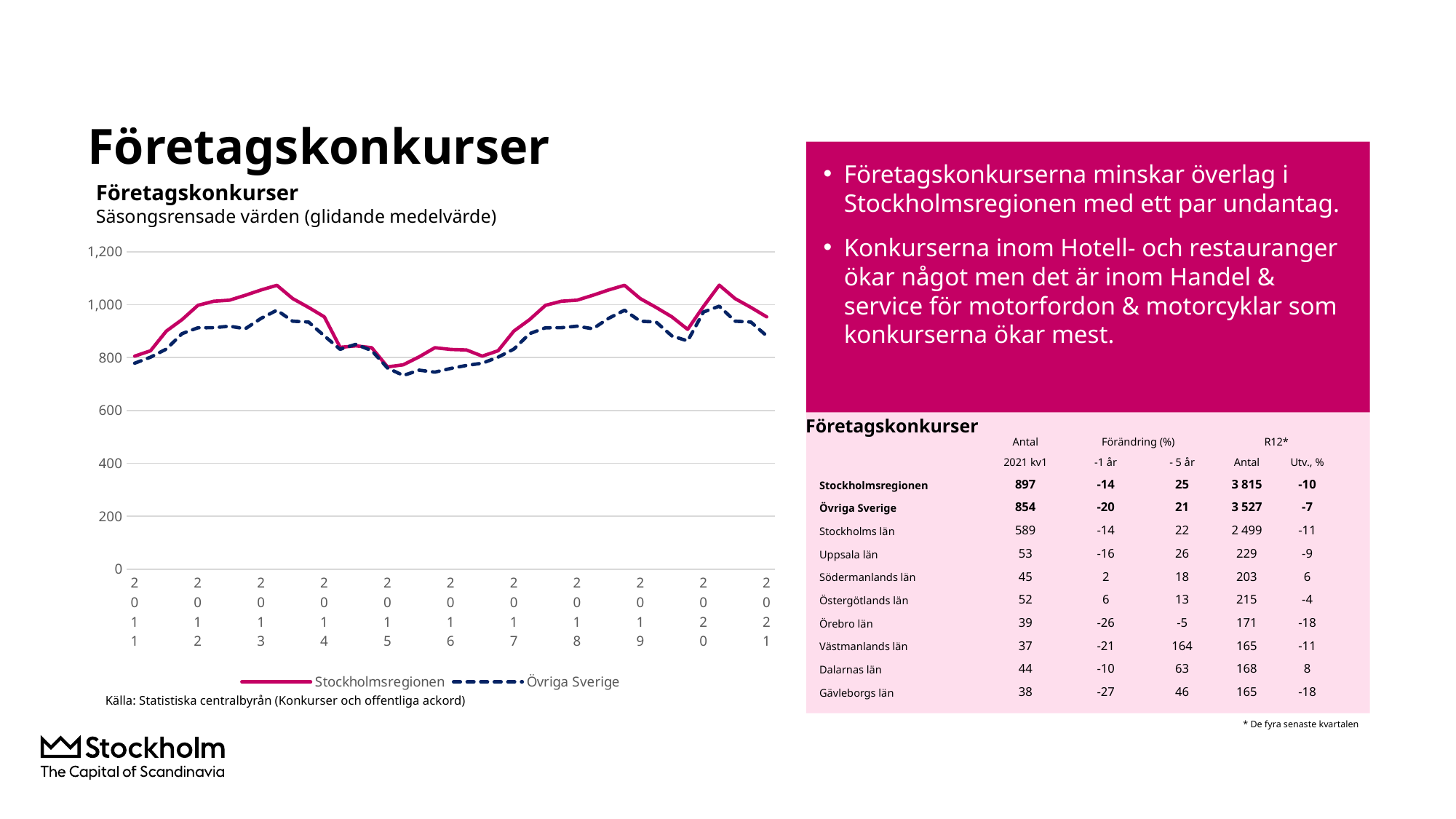
How many years are labelled along the x axis of the chart? 11 Is the value for Stockholmsregionen at its 2019 peak greater or less than 1,000? greater What kind of chart is shown on the slide? line chart Is the value for Övriga Sverige at its 2015 low point greater or less than 800? less In which year does the Övriga Sverige line reach its lowest point? 2015 How many series does the chart legend list? 2 Does the Stockholmsregionen line rise or fall between 2013 and 2015? fall Is the value for Stockholmsregionen at its 2013 peak greater or less than 1,000? greater At the 2013 peak, which series is higher, Stockholmsregionen or Övriga Sverige? Stockholmsregionen Which two series are listed in the chart legend? Stockholmsregionen and Övriga Sverige Which series reaches the highest value anywhere on the chart? Stockholmsregionen What is the subtitle printed under the chart title 'Företagskonkurser'? Säsongsrensade värden (glidande medelvärde)